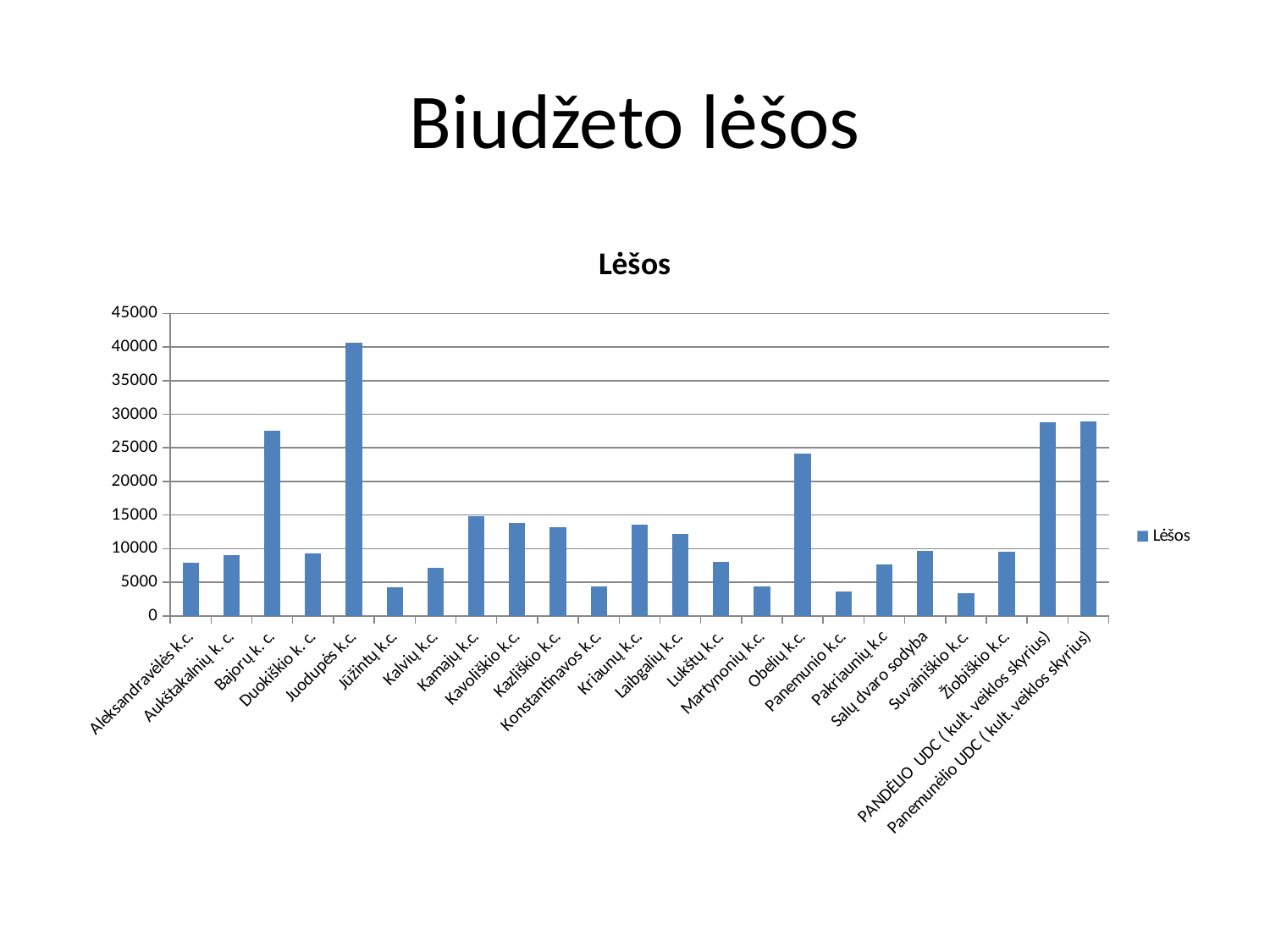
Is the value for Juodupės k.c. greater or less than 35000? greater How many categories are shown on the x axis? 23 What type of chart is shown on the slide? bar chart Is the value for Bajorų k. c. greater or less than 25000? greater Is the value for Obelių k.c. greater or less than 25000? less What is the title of the chart? Lėšos Which is larger, the value for Bajorų k. c. or the value for Obelių k.c.? Bajorų k. c. How many series does the legend list? 1 Which category has the highest value? Juodupės k.c. Which is larger, the value for Jūžintų k.c. or the value for Kalvių k.c.? Kalvių k.c.